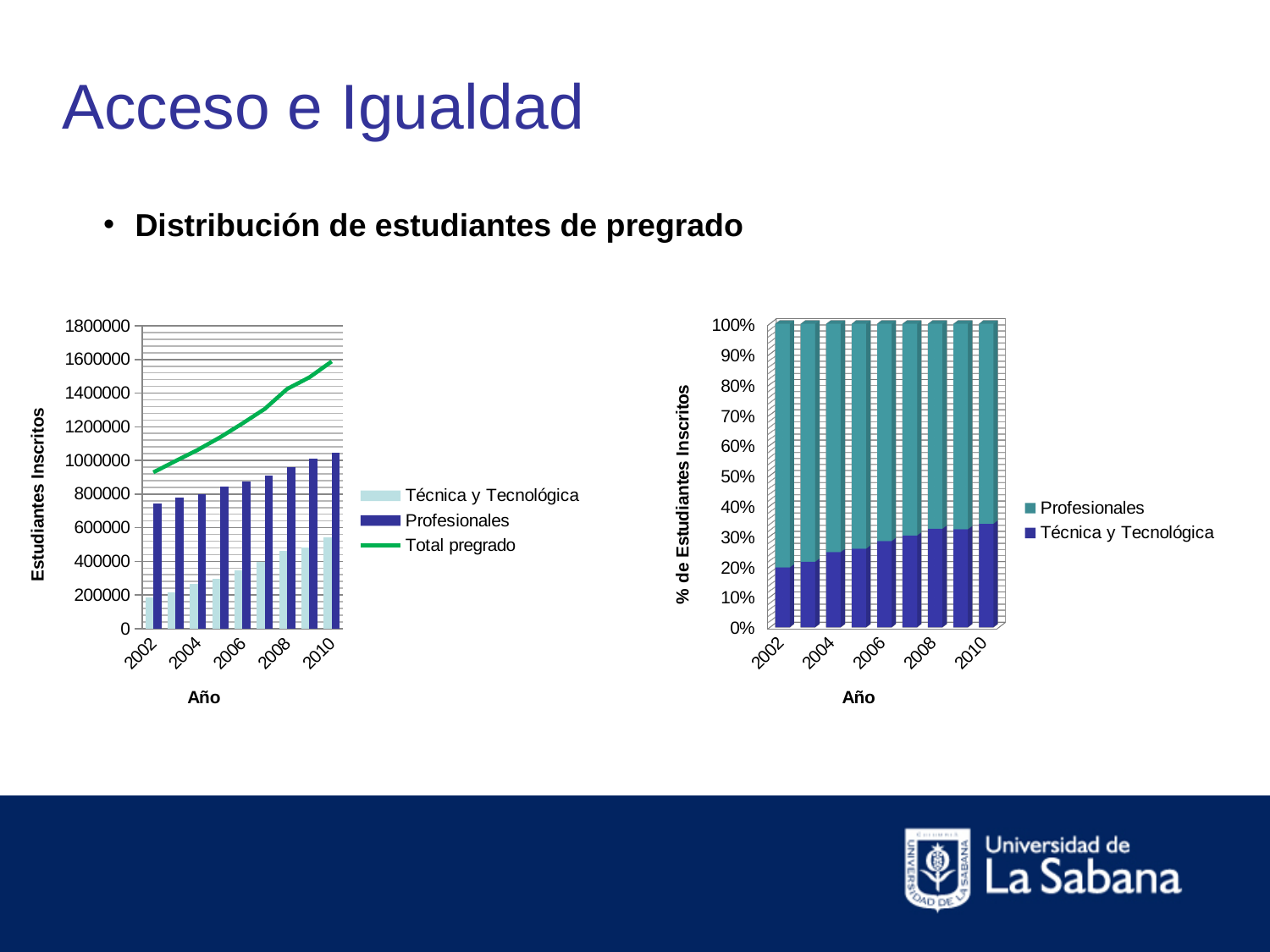
On the left chart, how many series does the legend list? 3 On the left chart, in which year is the Profesionales bar highest? 2010 On the left chart, is the value for Profesionales in 2002 greater or less than 800000? less On the left chart, how many years are plotted along the x axis? 9 On the left chart, which is larger in 2006, Profesionales or Técnica y Tecnológica? Profesionales On the right chart, does the share of Técnica y Tecnológica rise or fall from 2002 to 2010? rise On the right chart, is the share of Técnica y Tecnológica in 2010 greater or less than 30%? greater On the right chart, how many series does the legend list? 2 What is the label of the y axis on the right chart? % de Estudiantes Inscritos On the left chart, does the Total pregrado line rise or fall from 2002 to 2010? rise On the left chart, is the Total pregrado value in 2010 greater or less than 1400000? greater